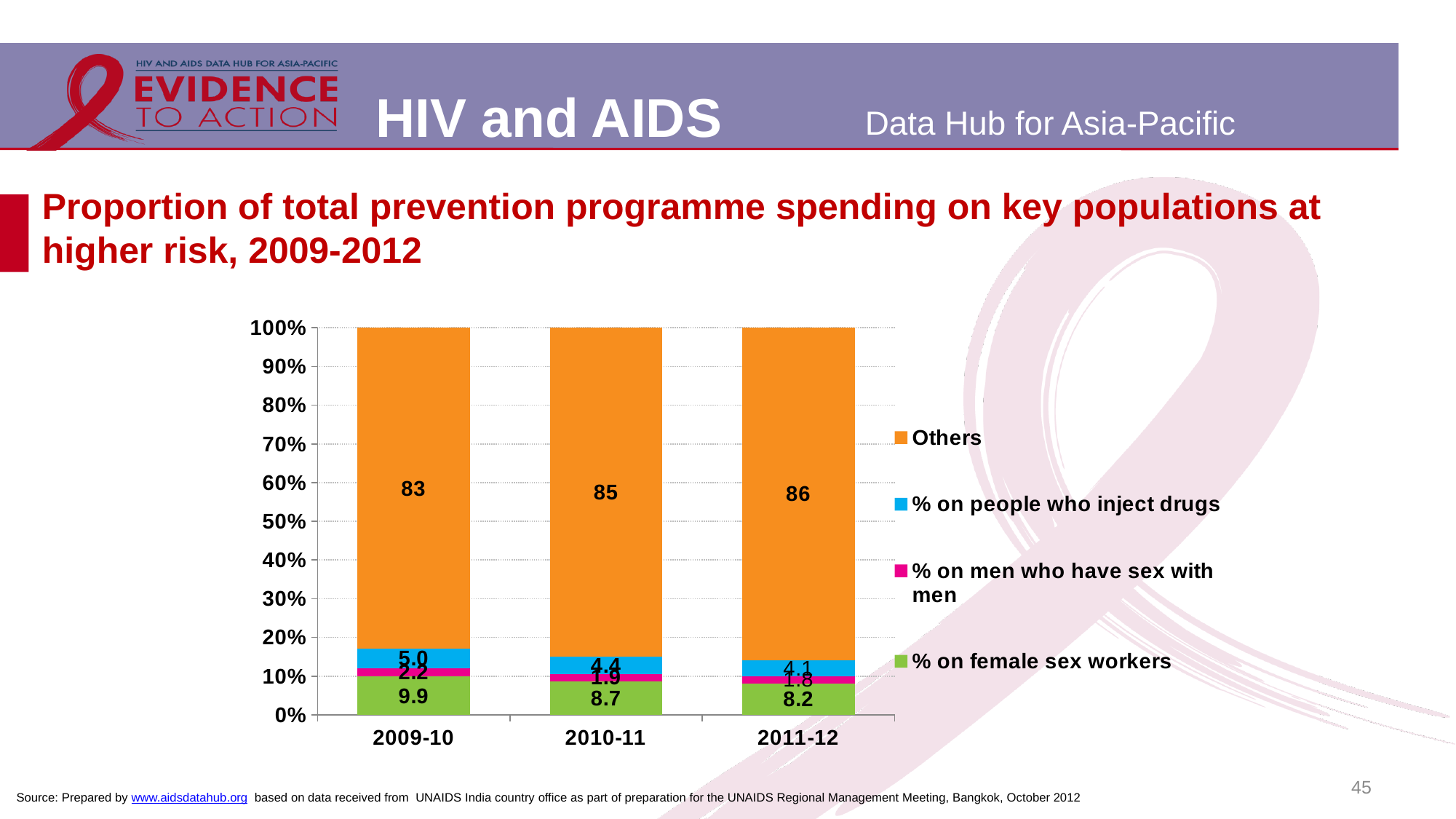
How many series does the legend list? 4 What is the value for % on men who have sex with men in 2009-10? 2.2 In which year is the value for Others highest? 2011-12 What is the value for % on female sex workers in 2011-12? 8.2 How many years are shown on the x axis? 3 What is the value for % on people who inject drugs in 2010-11? 4.4 Which is larger: the % on people who inject drugs value in 2009-10 or in 2011-12? 2009-10 Does the value for Others rise or fall from 2009-10 to 2011-12? Rise What kind of chart is shown on the slide? Stacked bar chart In which year is the value for % on female sex workers lowest? 2011-12 What is the difference between the % on female sex workers values for 2009-10 and 2011-12? 1.7 What is the value for Others in 2009-10? 83